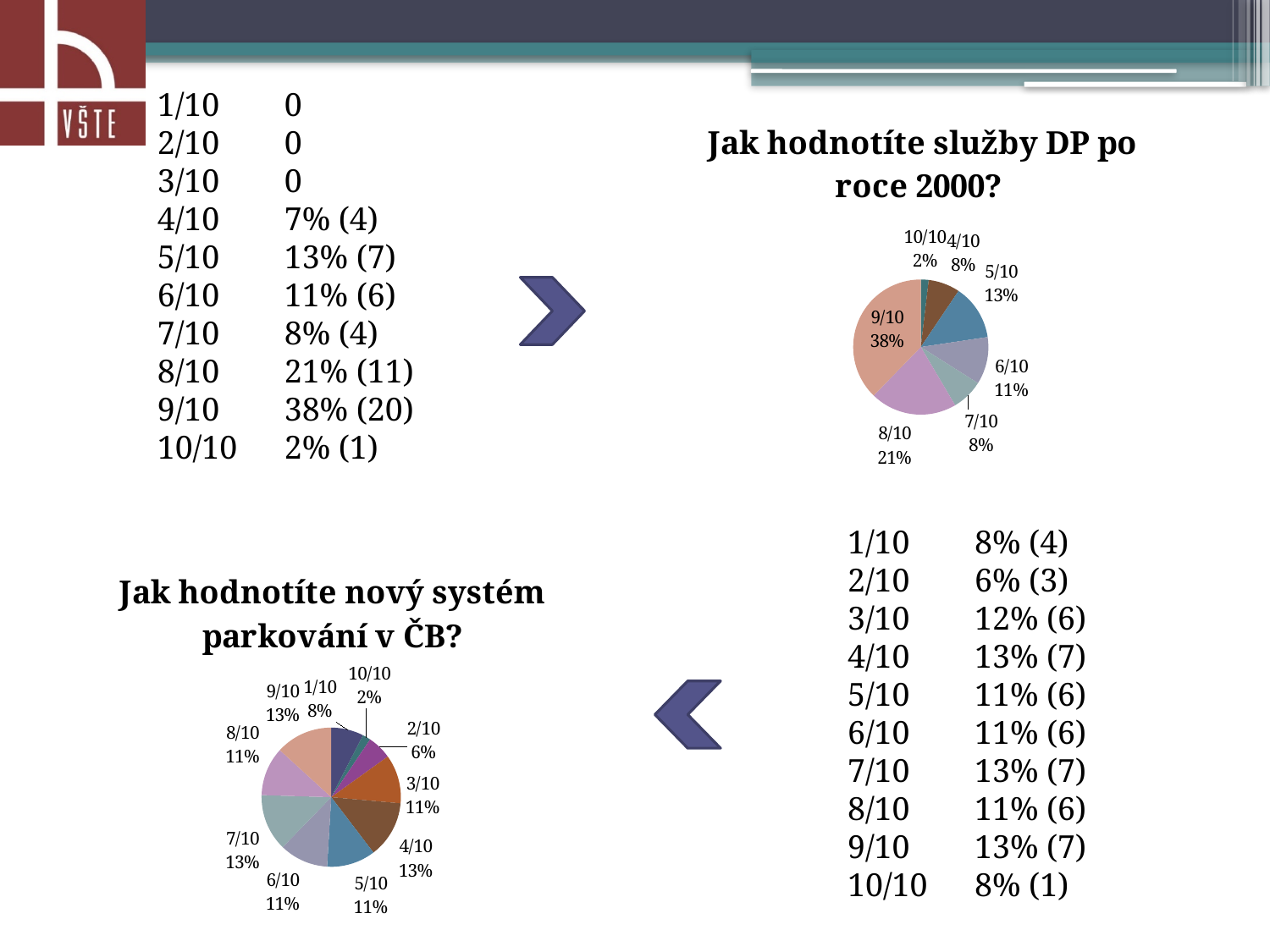
In the chart "Jak hodnotíte služby DP po roce 2000?", what share does the 8/10 slice have? 21% In the chart "Jak hodnotíte nový systém parkování v ČB?", what share does the 2/10 slice have? 6% In the chart "Jak hodnotíte služby DP po roce 2000?", how many slices does the pie have? 7 How many pie charts are shown on the slide? 2 In the chart "Jak hodnotíte nový systém parkování v ČB?", which rating has the smallest slice? 10/10 In the chart "Jak hodnotíte služby DP po roce 2000?", which rating has the largest slice? 9/10 In the chart "Jak hodnotíte služby DP po roce 2000?", what share does the 9/10 slice have? 38% In the chart "Jak hodnotíte nový systém parkování v ČB?", how many slices does the pie have? 10 In the chart "Jak hodnotíte služby DP po roce 2000?", what is the difference in percentage points between the 9/10 and 8/10 slices? 17 What type of chart is used for "Jak hodnotíte služby DP po roce 2000?"? pie chart In the chart "Jak hodnotíte služby DP po roce 2000?", which rating has the smallest slice? 10/10 In the chart "Jak hodnotíte nový systém parkování v ČB?", which slice is larger, 4/10 or 2/10? 4/10